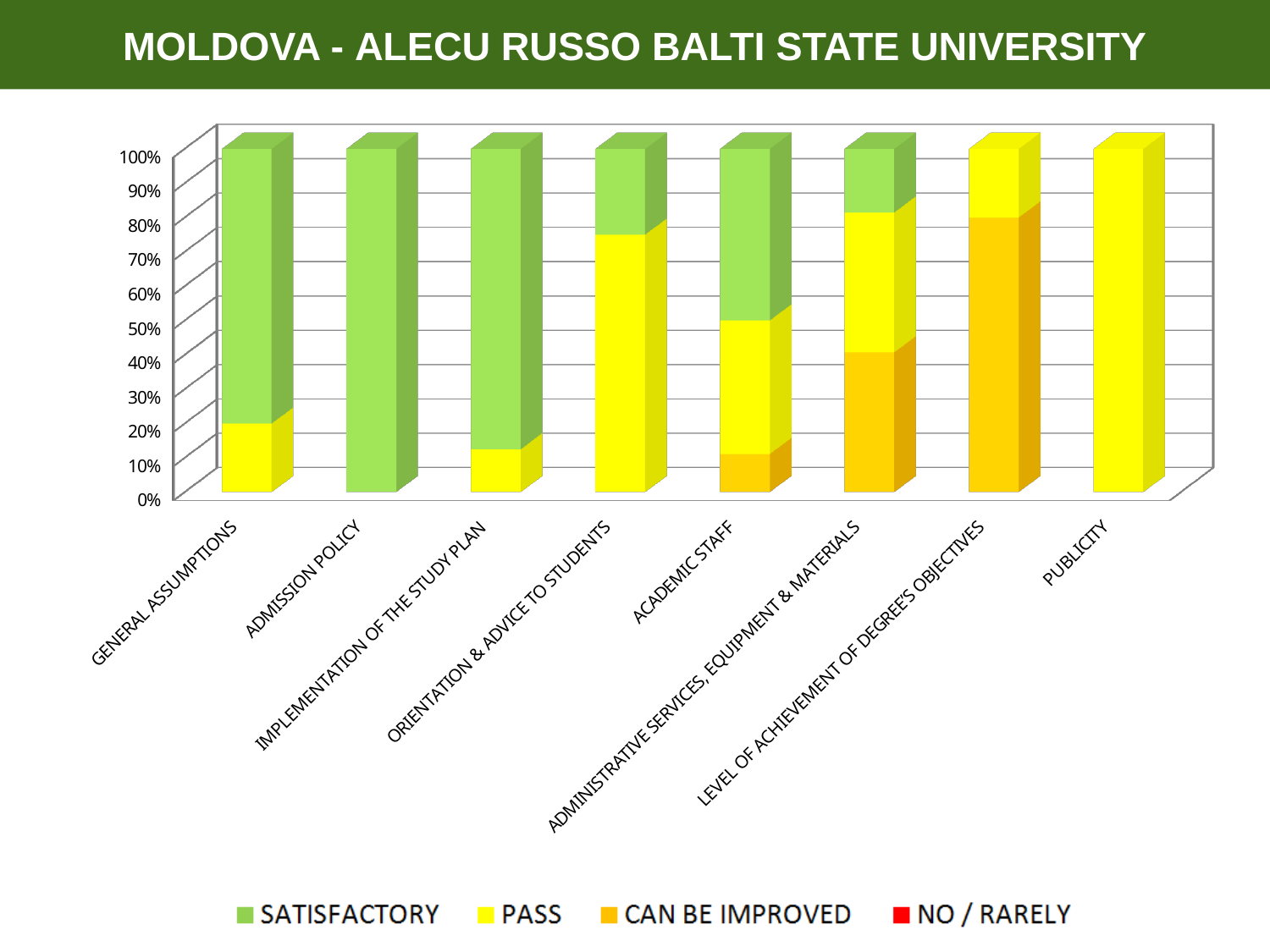
Which category has the largest PASS segment? PUBLICITY Is the PASS value for ORIENTATION & ADVICE TO STUDENTS greater or less than 50%? greater Which legend entry is shown in red? NO / RARELY Which is larger, the SATISFACTORY value for ADMISSION POLICY or the SATISFACTORY value for ORIENTATION & ADVICE TO STUDENTS? ADMISSION POLICY How many series does the chart's legend list? 4 What kind of chart is shown on the slide? Stacked bar chart Is the SATISFACTORY value for ADMINISTRATIVE SERVICES, EQUIPMENT & MATERIALS greater or less than 30%? less Is the PASS value for GENERAL ASSUMPTIONS greater or less than 30%? less How many categories are shown along the x axis of the chart? 8 Which category has the largest SATISFACTORY segment? ADMISSION POLICY Which category has the largest CAN BE IMPROVED segment? LEVEL OF ACHIEVEMENT OF DEGREE'S OBJECTIVES